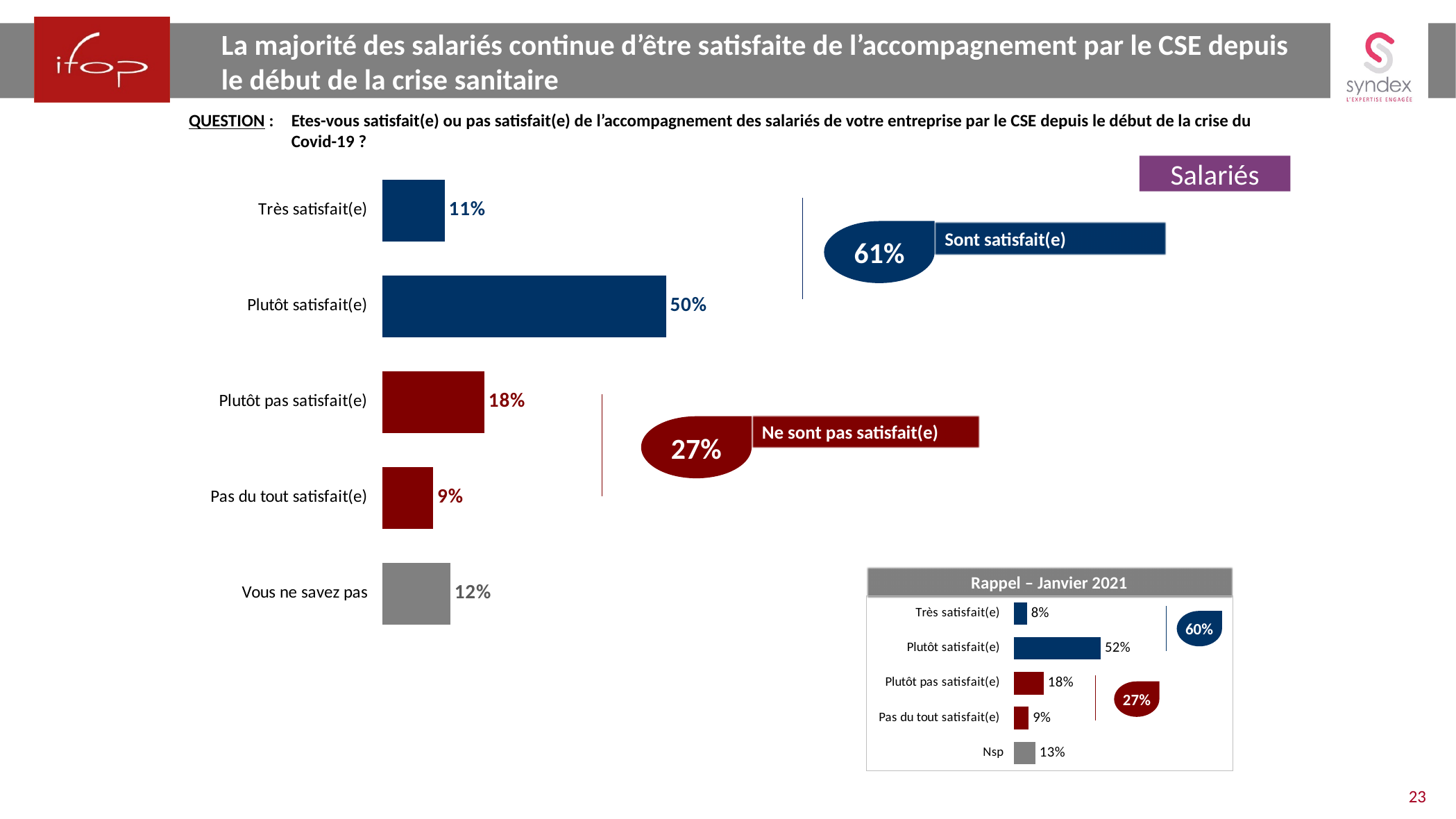
In the main bar chart, which category has the highest value? Plutôt satisfait(e) How many categories does the main bar chart show? 5 In the "Rappel – Janvier 2021" chart, what is the difference between "Très satisfait(e)" and "Plutôt pas satisfait(e)"? 10% In the main bar chart, what is the value for "Plutôt satisfait(e)"? 50% In the "Rappel – Janvier 2021" chart, what is the value for "Nsp"? 13% In the main bar chart, which category has the lowest value? Pas du tout satisfait(e) In the main bar chart, what is the difference between "Plutôt satisfait(e)" and "Plutôt pas satisfait(e)"? 32% In the main bar chart, which is larger: "Très satisfait(e)" or "Vous ne savez pas"? Vous ne savez pas In the "Rappel – Janvier 2021" chart, what is the value for "Plutôt satisfait(e)"? 52% In the main chart, what percentage is shown in the oval labelled "Sont satisfait(e)"? 61% What type of chart is the main chart on the slide? Bar chart In the main bar chart, what is the value for "Pas du tout satisfait(e)"? 9%